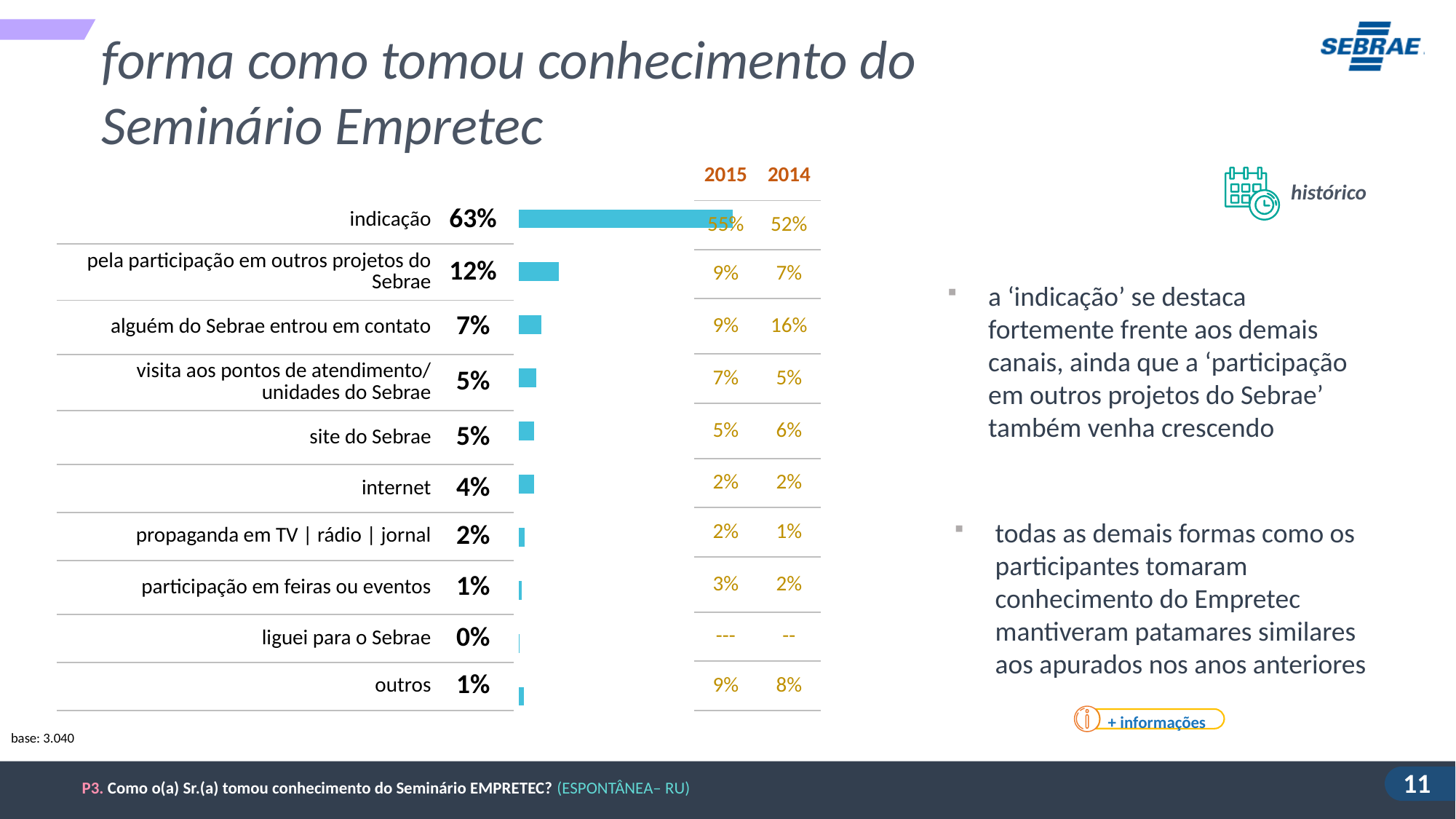
What is the value for 'indicação' in the bar chart? 63% What is the value for 'internet'? 4% What is the value for 'pela participação em outros projetos do Sebrae'? 12% What is the value for 'propaganda em TV | rádio | jornal'? 2% Which category has the lowest value in the bar chart? liguei para o Sebrae How many categories are shown in the bar chart? 10 What is the difference between the values for 'indicação' and 'pela participação em outros projetos do Sebrae'? 51 percentage points Which category has the highest value in the bar chart? indicação What was the 2014 value for 'alguém do Sebrae entrou em contato' in the histórico columns? 16% What kind of chart is shown on the slide? bar chart Which is larger, the value for 'site do Sebrae' or the value for 'internet'? site do Sebrae What is the value for 'alguém do Sebrae entrou em contato'? 7%